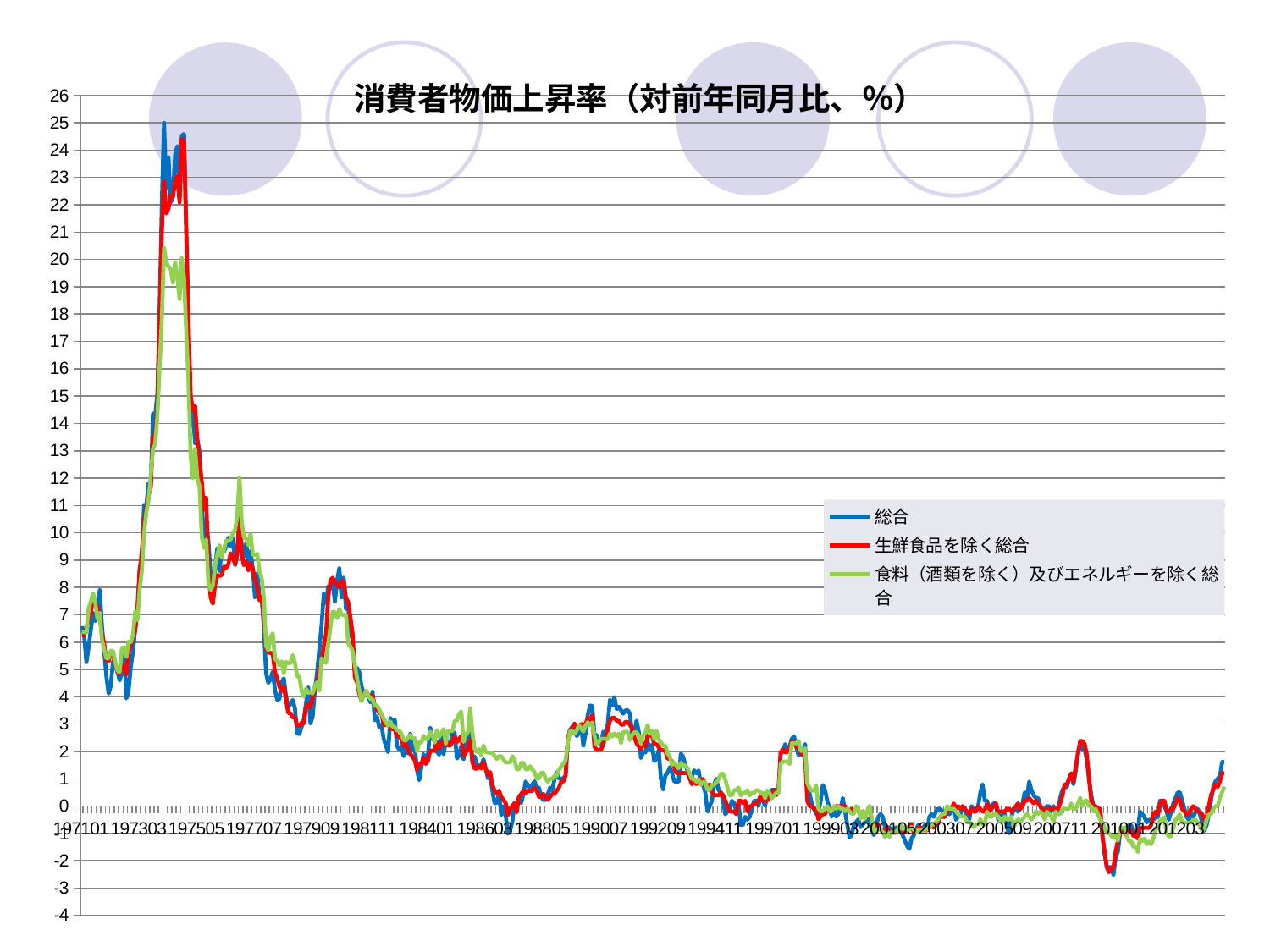
Is the peak value of the 食料（酒類を除く）及びエネルギーを除く総合 series greater or less than 15? greater Is the value of the 総合 series at 201203 greater or less than 5? less Is the peak value of the 総合 series greater or less than 20? greater What is the highest value shown on the vertical axis? 26 How many series does the legend list? 3 At the peak around 1974, which series is higher: 総合 or 食料（酒類を除く）及びエネルギーを除く総合? 総合 What kind of chart is shown on the slide? line chart Which series is drawn in red? 生鮮食品を除く総合 Overall, do the values rise or fall along the x axis from the 1974 peak to the end of the series? fall What is the title of the chart? 消費者物価上昇率（対前年同月比、%）